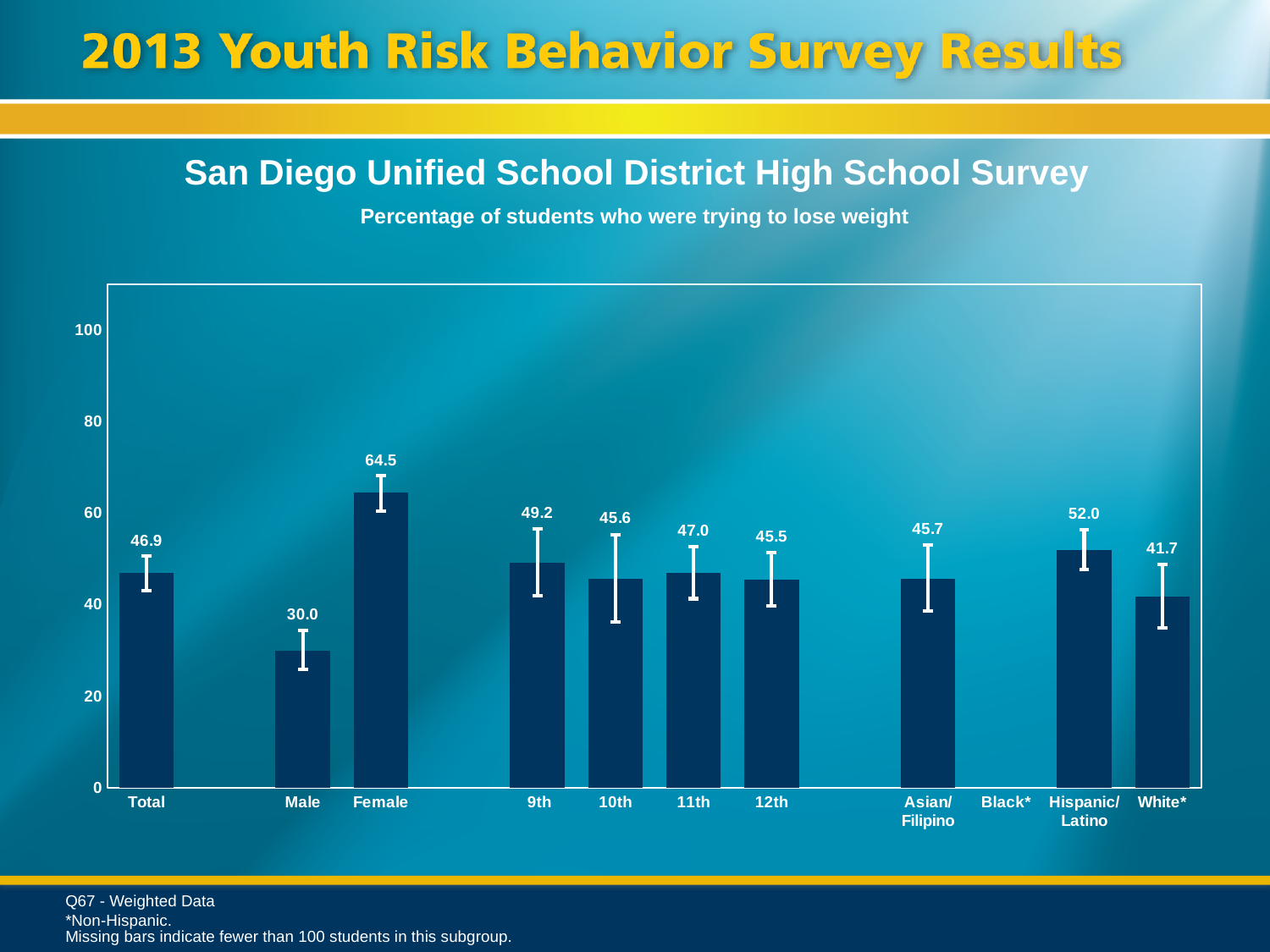
What percentage of female students were trying to lose weight? 64.5 Which category label has no bar plotted? Black* How many bars are plotted in the chart? 10 Which category has the lowest plotted value? Male What type of chart is shown on the slide? bar chart What is the difference between the Hispanic/Latino and White* values? 10.3 What is the value shown for the Total bar? 46.9 What is the value for Hispanic/Latino students? 52.0 What is the difference between the Female and Male values? 34.5 Is the value for White* students greater or less than 40? greater Which is larger, the value for 9th grade or the value for 12th grade? 9th Which category has the highest value in the chart? Female